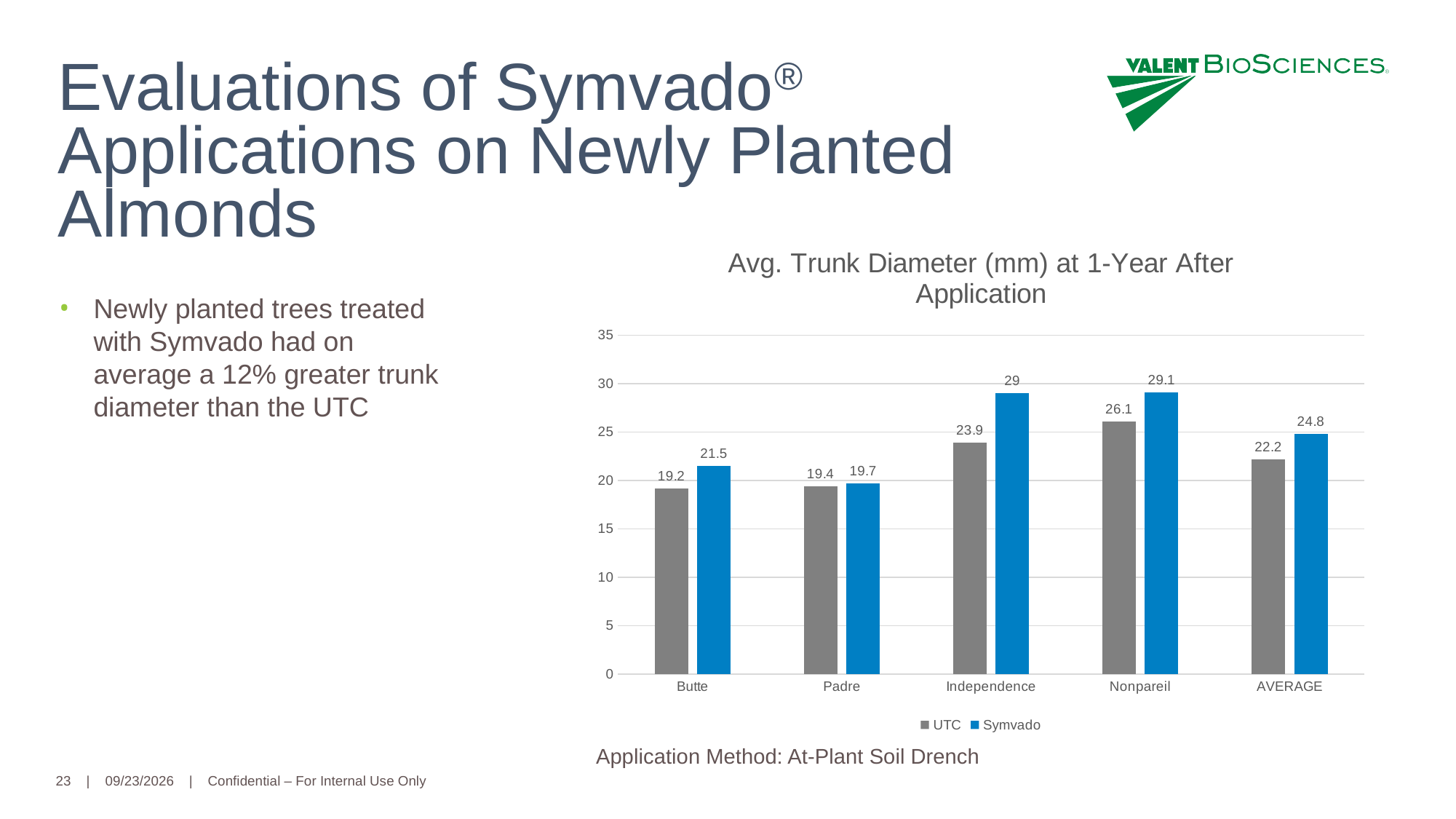
What is the Symvado value for AVERAGE? 24.8 What is the UTC value for Butte? 19.2 Is the UTC value for Nonpareil greater or less than 25? greater What kind of chart is shown? bar chart Which is larger for Nonpareil, the UTC value or the Symvado value? Symvado How many categories are shown on the x axis? 5 What is the difference between the Symvado and UTC values for Independence? 5.1 Which category has the lowest UTC value? Butte What is the Symvado value for Independence? 29 Which category has the highest Symvado value? Nonpareil What is the title of the chart? Avg. Trunk Diameter (mm) at 1-Year After Application How many series does the legend list? 2